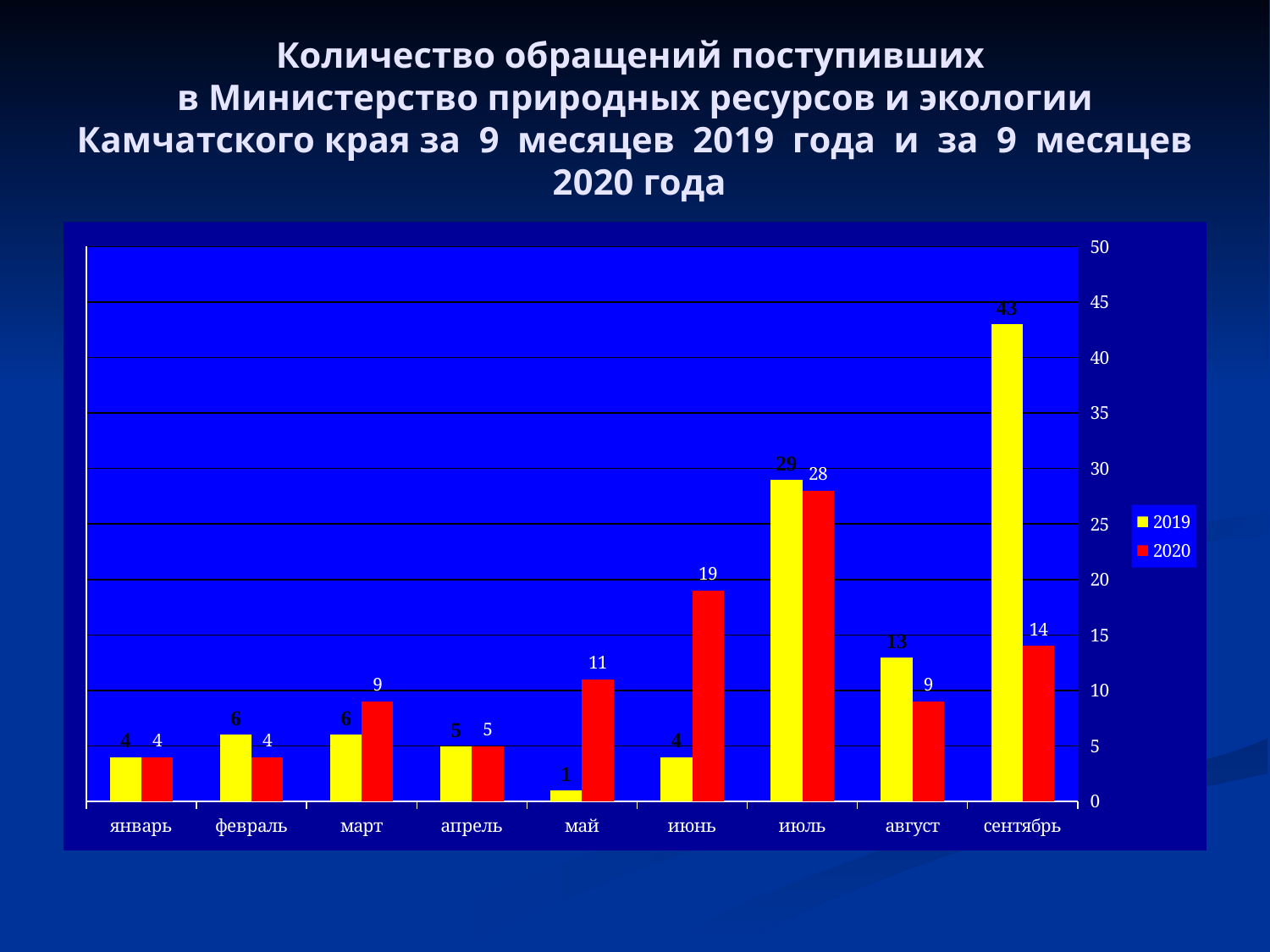
Which colour represents the 2020 series? red What is the difference between the 2019 and 2020 values in сентябрь? 29 What is the value for 2020 in июнь? 19 What is the difference between the 2020 values for май and март? 2 How many series does the legend list? 2 How many months are shown on the x axis? 9 Which is larger in август: the 2019 value or the 2020 value? 2019 What is the value for 2019 in май? 1 What is the value for 2019 in сентябрь? 43 What type of chart is shown on the slide? bar chart Which month has the highest value for the 2020 series? июль Which month has the lowest value for the 2019 series? май